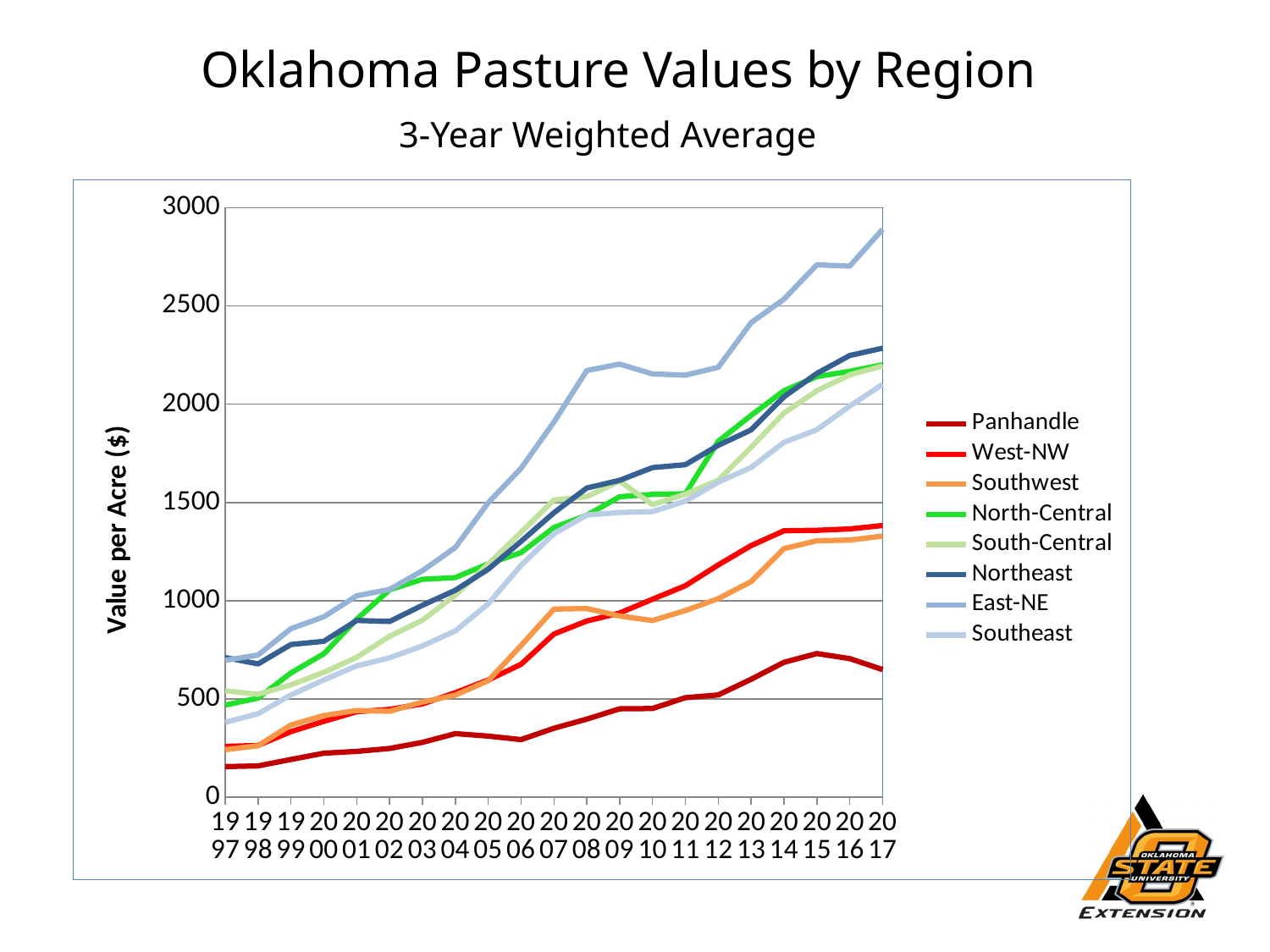
How many series does the legend list? 8 Which region has the lowest pasture value in 2017? Panhandle How many years are shown along the x axis? 21 Is the value for East-NE in 2017 greater or less than 2500? greater Is the value for Southeast in 1997 greater or less than 500? less Is the value for Northeast in 2017 greater or less than 2000? greater Which is larger in 2017, the value for West-NW or the value for North-Central? North-Central What is the label on the y axis? Value per Acre ($) Which region has the highest pasture value in 2017? East-NE Do the Panhandle values generally rise or fall from 1997 to 2017? rise What kind of chart is shown on the slide? line chart